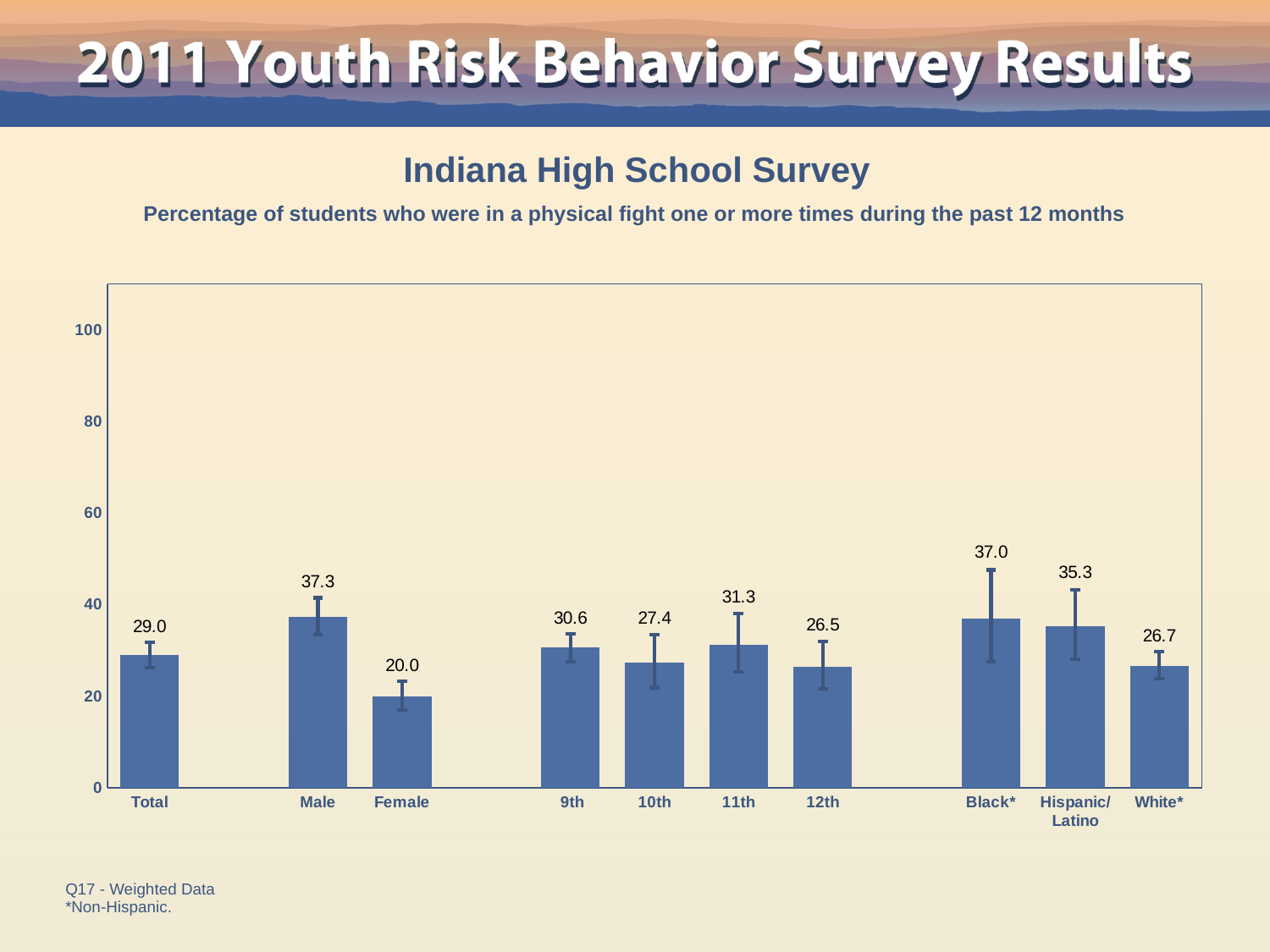
What is the value for Total? 29.0 How many categories are shown on the chart? 10 What is the difference between the Male and Female values? 17.3 What is the difference between the Black* and White* values? 10.3 What is the value for Female? 20.0 Is the value for 11th greater or less than 40? less Which category has the highest value? Male Which category has the lowest value? Female What is the value for Hispanic/Latino? 35.3 What is the title of the chart? Indiana High School Survey Which is larger, the value for 9th or the value for 12th? 9th What kind of chart is shown on the slide? bar chart